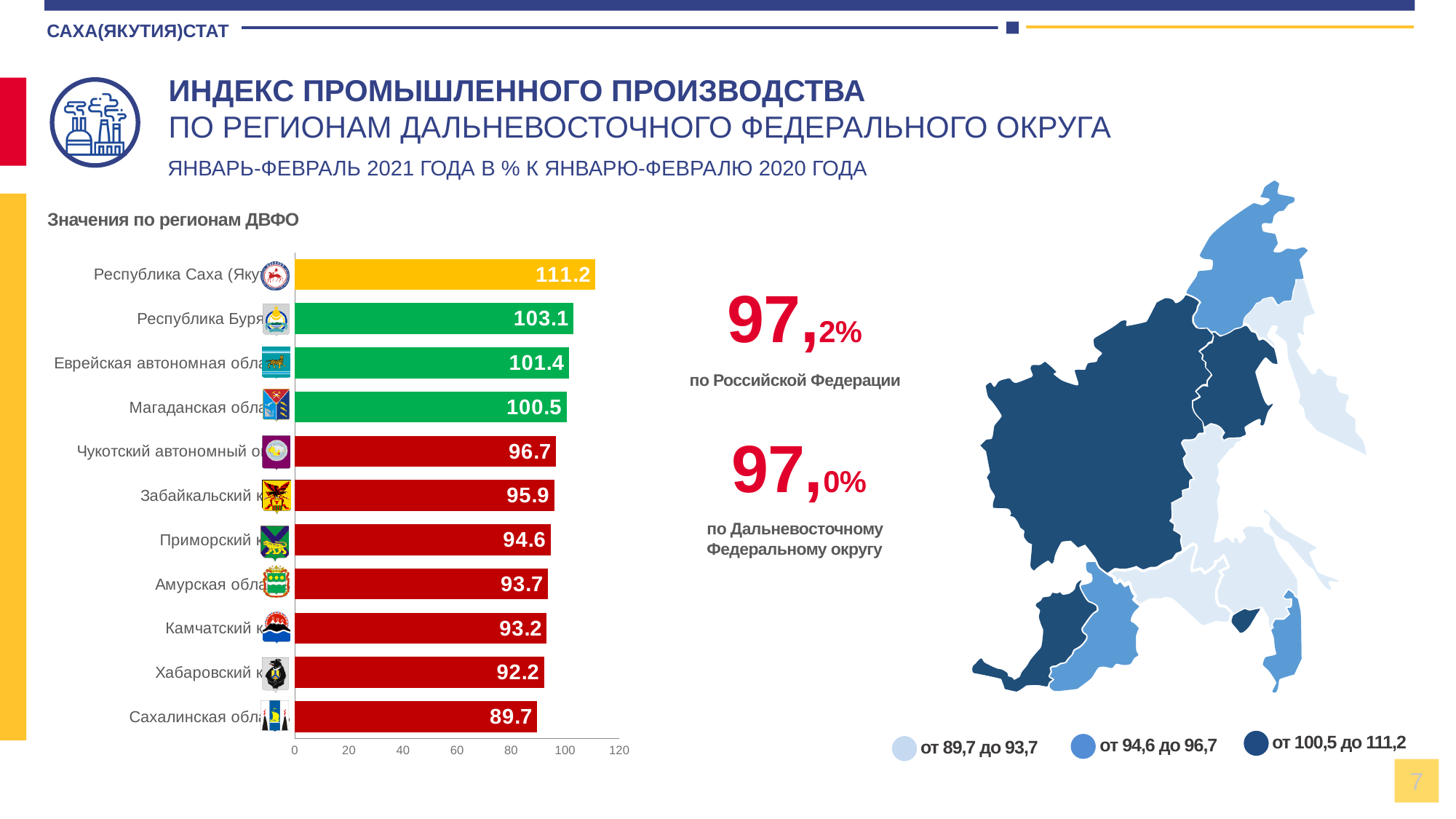
What colour is the bar for Республика Саха (Якутия)? yellow What is the value for Республика Саха (Якутия)? 111.2 What is the value for Хабаровский край? 92.2 Is the value for Амурская область greater or less than 100? less Which region has the highest value? Республика Саха (Якутия) What is the difference between the values for Республика Саха (Якутия) and Сахалинская область? 21.5 Which region has the lowest value? Сахалинская область How many regions are shown in the bar chart? 11 What is the value for Магаданская область? 100.5 What is the difference between the values for Республика Бурятия and Еврейская автономная область? 1.7 What kind of chart is shown on the slide? bar chart Which is larger, the value for Чукотский автономный округ or the value for Приморский край? Чукотский автономный округ